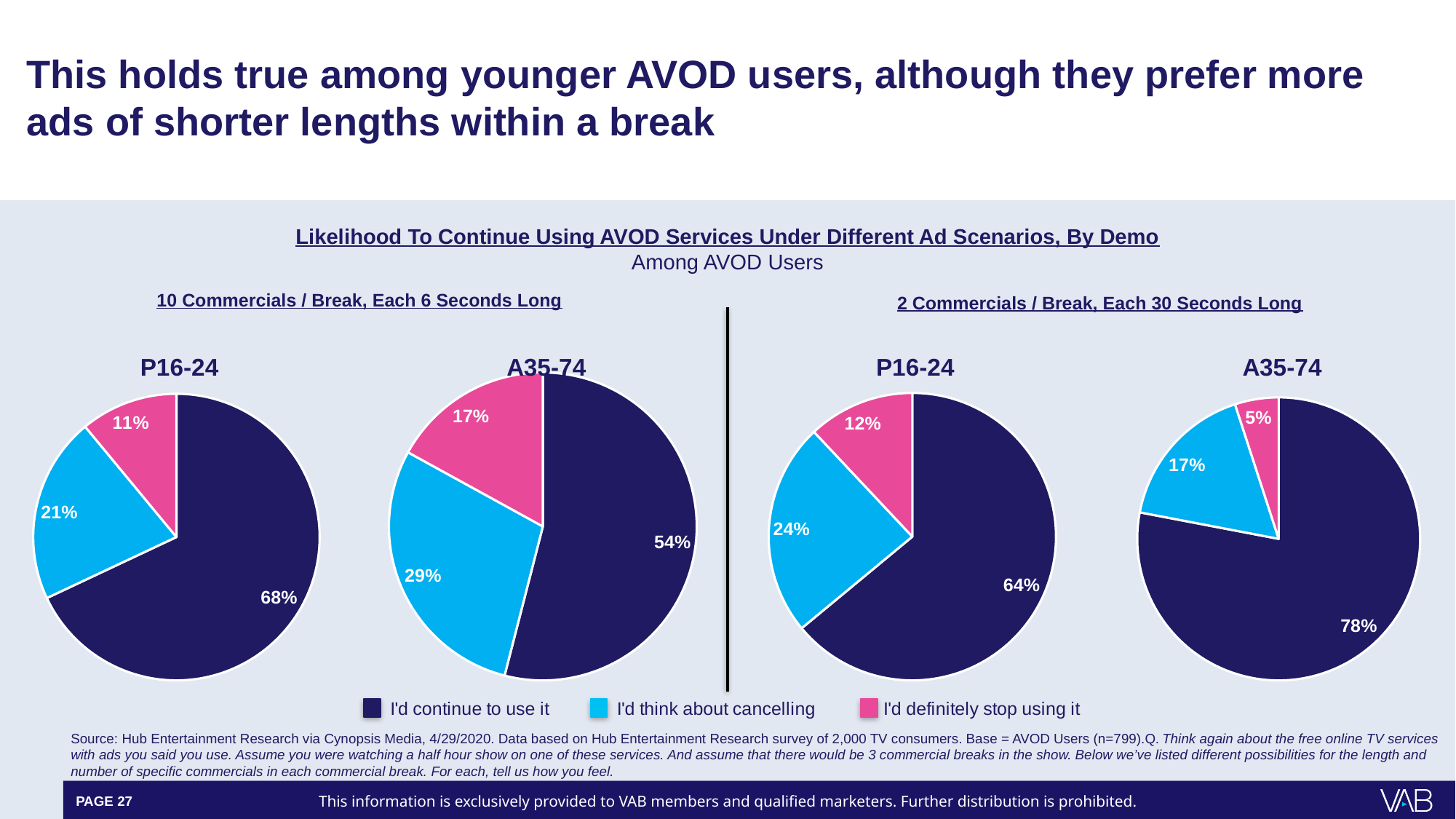
What type of chart is used to show the likelihood to continue using AVOD services? Pie chart In the P16-24 pie chart under '10 Commercials / Break, Each 6 Seconds Long', what share said 'I'd continue to use it'? 68% In the A35-74 pie chart under '2 Commercials / Break, Each 30 Seconds Long', which response has the largest slice? I'd continue to use it In the A35-74 pie chart under '10 Commercials / Break, Each 6 Seconds Long', what share said 'I'd think about cancelling'? 29% In the P16-24 pie chart under '2 Commercials / Break, Each 30 Seconds Long', what share said 'I'd think about cancelling'? 24% In the A35-74 pie chart under '10 Commercials / Break, Each 6 Seconds Long', which response has the smallest slice? I'd definitely stop using it In the A35-74 pie chart under '2 Commercials / Break, Each 30 Seconds Long', what share said 'I'd definitely stop using it'? 5% Which is larger: the 'I'd continue to use it' share for P16-24 under '10 Commercials / Break, Each 6 Seconds Long' or under '2 Commercials / Break, Each 30 Seconds Long'? 10 Commercials / Break, Each 6 Seconds Long (68%) What is the difference between the 'I'd definitely stop using it' shares for P16-24 and A35-74 under '10 Commercials / Break, Each 6 Seconds Long'? 6 percentage points How many pie charts are shown on the slide? 4 What is the difference between the 'I'd continue to use it' share for A35-74 under '2 Commercials / Break, Each 30 Seconds Long' (78%) and under '10 Commercials / Break, Each 6 Seconds Long' (54%)? 24 percentage points How many response categories does the legend list? 3